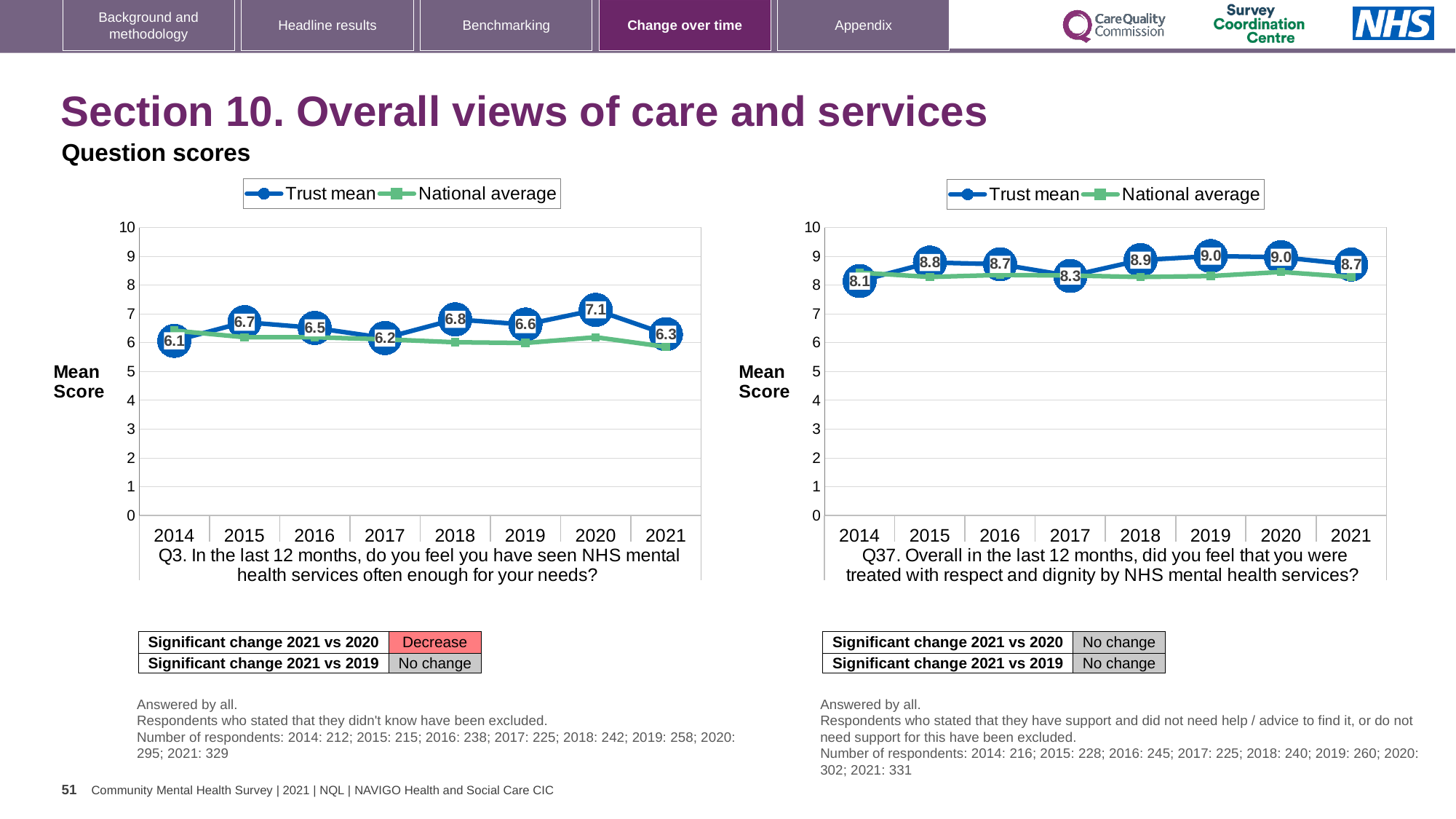
In the Q3 chart on the left, what is the difference between the Trust mean scores for 2020 and 2021? 0.8 In the Q37 chart on the right, what is the Trust mean score for 2017? 8.3 In the Q3 chart on the left, which year has the lowest Trust mean score? 2014 How many years are plotted on the x axis of the Q3 chart on the left? 8 In the Q3 chart on the left, which year has the highest Trust mean score? 2020 In the Q37 chart on the right, is the National average value for 2014 greater or less than 8? greater In the Q37 chart on the right, what is the difference between the Trust mean scores for 2015 and 2014? 0.7 In the Q37 chart on the right, which year has the lowest Trust mean score? 2014 In the Q3 chart on the left, which year has the larger Trust mean score, 2018 or 2019? 2018 How many series does the legend of the Q37 chart on the right list? 2 What kind of chart is the Q3 chart on the left? Line chart In the Q3 chart on the left, what is the Trust mean score for 2020? 7.1